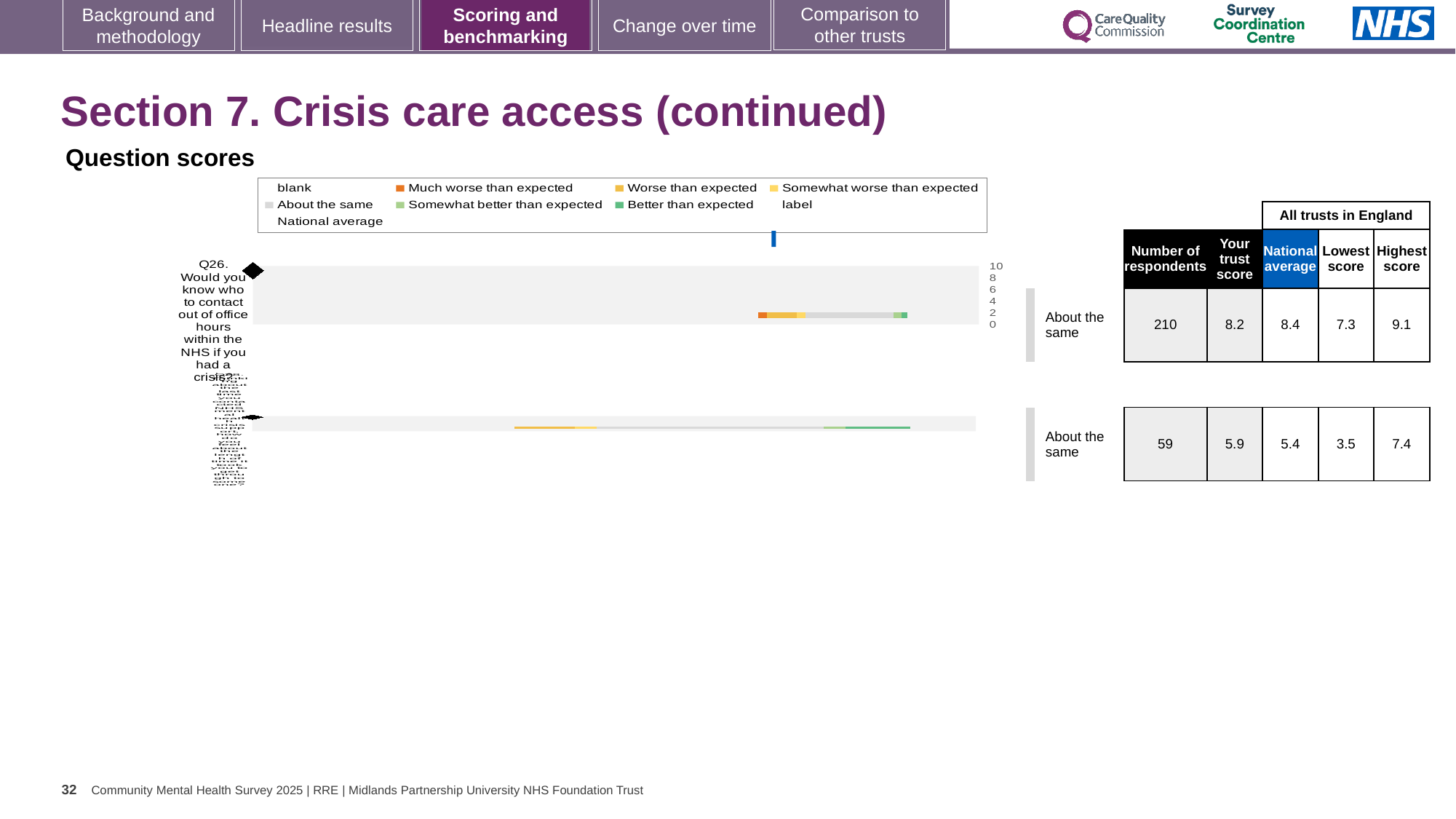
What is the trust score for Q26? 8.2 What is the trust score for the second (lower) question row? 5.9 What is the national average for Q26? 8.4 Which question row has the higher number of respondents, Q26 or the second (lower) row? Q26 What is the number of respondents for Q26? 210 What is the difference between the highest score and the lowest score for Q26? 1.8 What is the benchmark category shown for Q26 (Would you know who to contact out of office hours within the NHS if you had a crisis)? About the same How many question bars are plotted in the chart? 2 For Q26, which is larger: the trust score or the national average? National average What is the lowest score across all trusts in England for the second (lower) question row? 3.5 What kind of chart is shown under 'Question scores'? Bar chart Which legend entry is shown with an orange marker? Much worse than expected